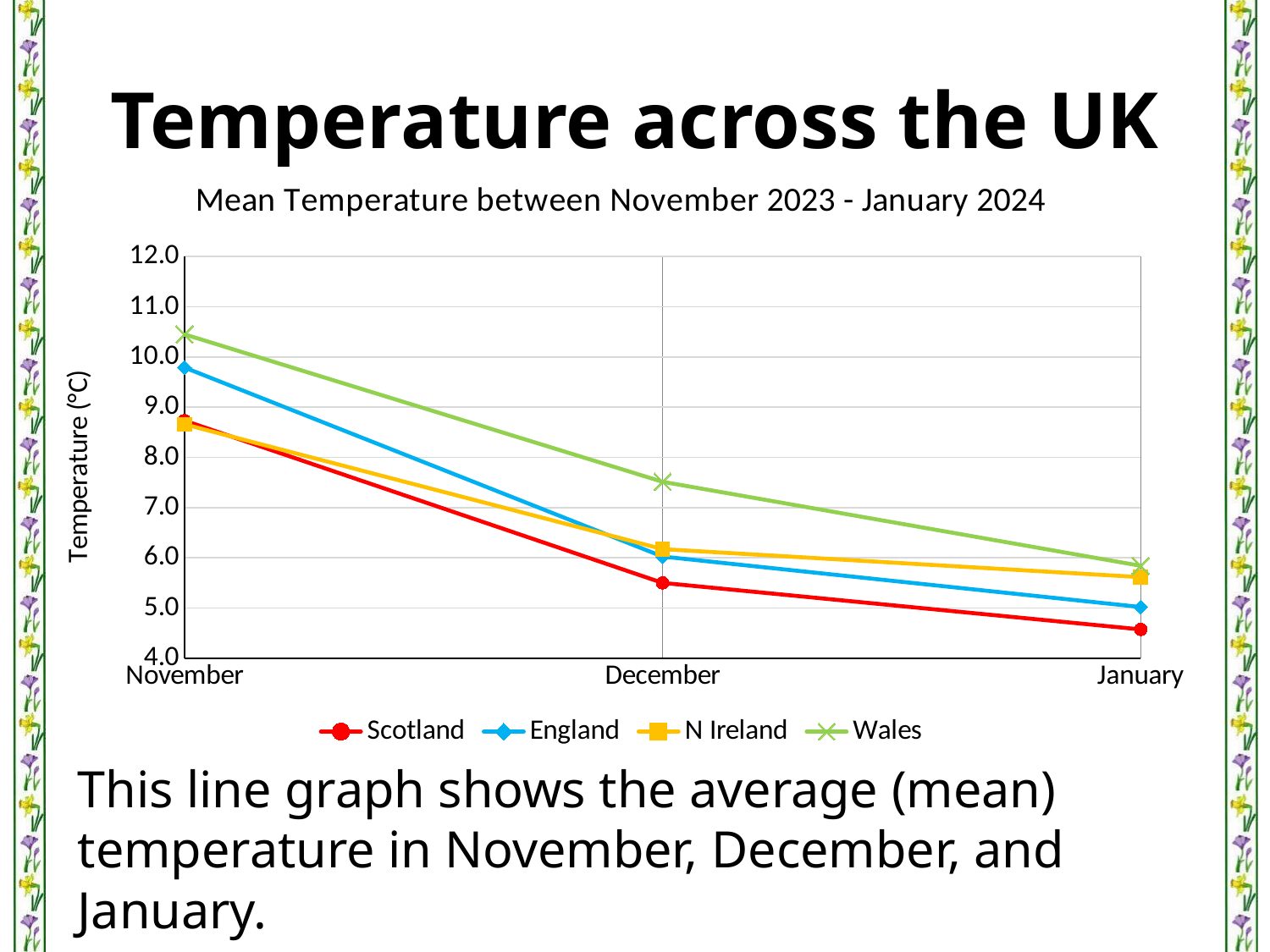
Do the temperatures for Wales rise or fall from November to January? fall Is the value for Wales in December greater or less than 7.0? greater Which series has the lowest temperature in January? Scotland What kind of chart is shown on the slide? line chart Which series has the lowest temperature in December? Scotland Is the value for Wales in November greater or less than 10.0? greater In December, which is higher: Wales or England? Wales Is the value for England in November greater or less than 9.0? greater How many series does the legend list? 4 Which series has the highest temperature in November? Wales How many months are plotted along the x axis? 3